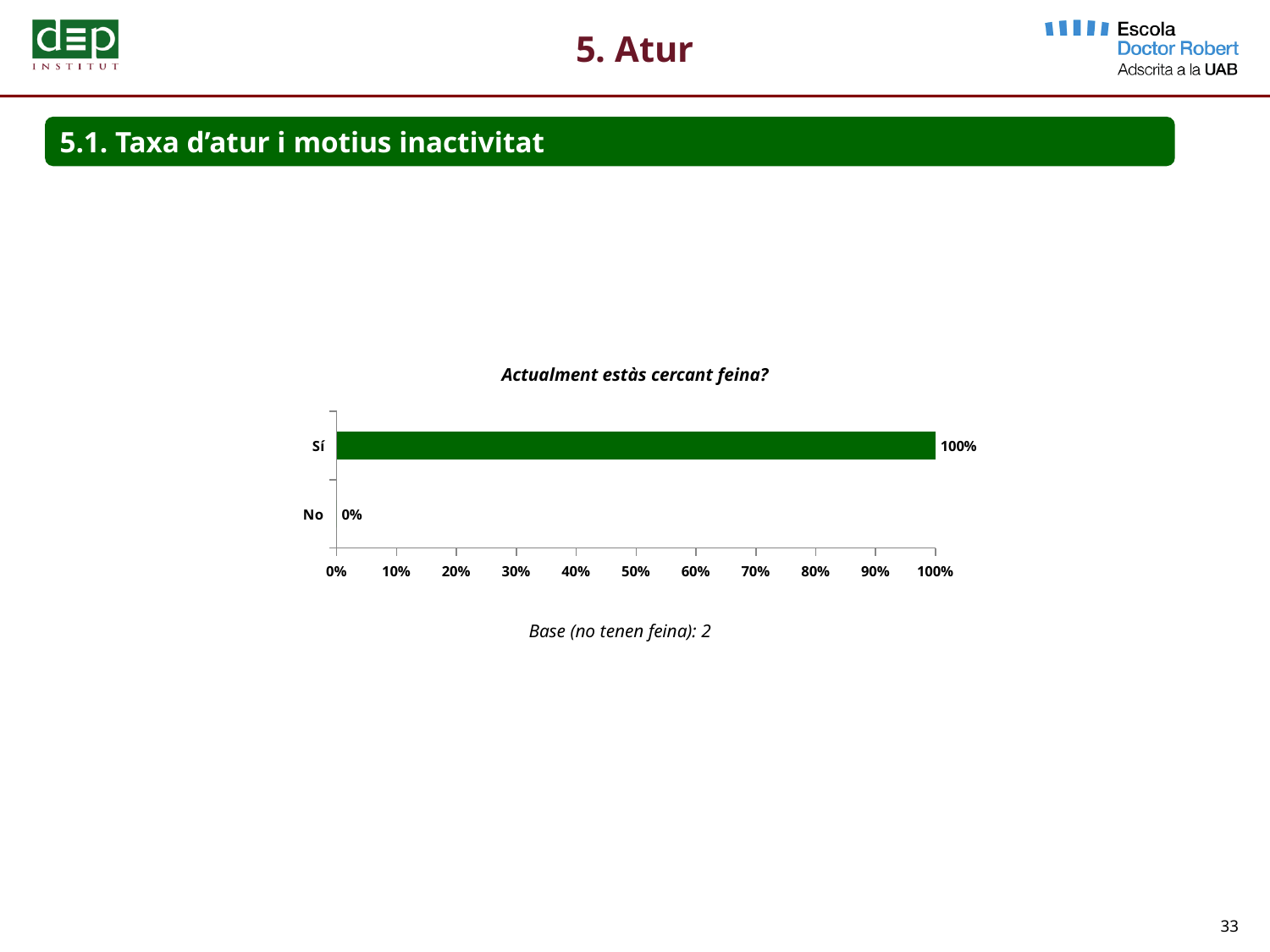
What kind of chart is shown on the slide? bar chart What is the value for "No"? 0% Which category has the lowest value? No What is the highest value shown on the x axis? 100% What is the base (number of respondents) noted below the chart? 2 What is the difference between the values for "Sí" and "No"? 100% What is the value for "Sí"? 100% Which category has the highest value? Sí Which is larger, the value for "Sí" or the value for "No"? Sí Is the value for "Sí" greater or less than 50%? greater How many categories are shown in the chart? 2 What is the title of the chart? Actualment estàs cercant feina?